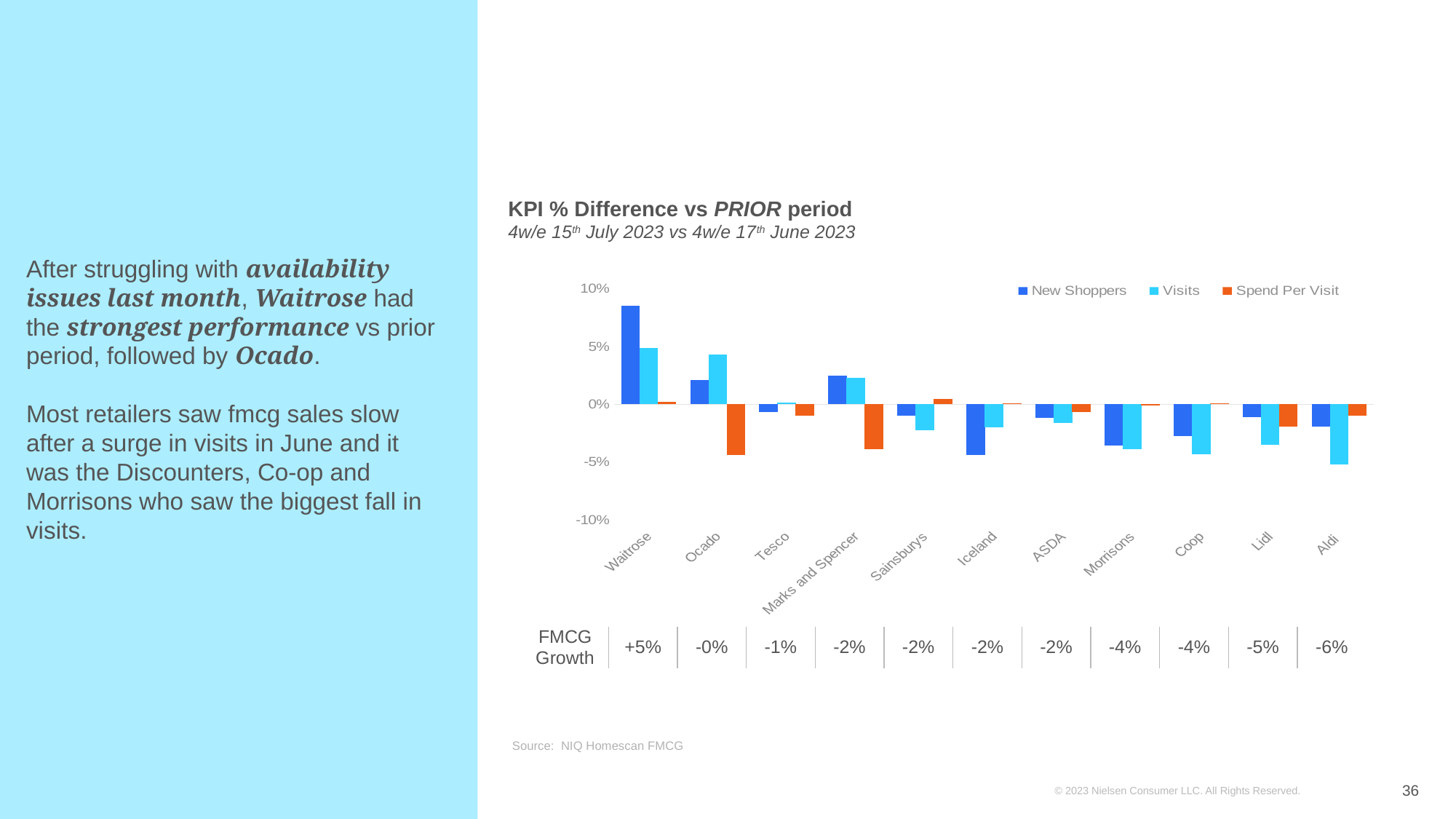
How many series does the legend list? 3 How many retailers are shown on the x axis of the chart? 11 Is the New Shoppers value for Waitrose greater or less than 5%? greater Which series in the legend is shown in orange? Spend Per Visit What kind of chart is shown on the slide? bar chart Which retailer has the highest New Shoppers value? Waitrose Is the Spend Per Visit value for Ocado greater or less than 0%? less What is the FMCG Growth figure shown for Waitrose below the chart? +5% Do the New Shoppers values generally rise or fall moving from Waitrose to Aldi along the x axis? fall Which retailer has the lowest Visits value? Aldi Which is larger, the New Shoppers value for Waitrose or for Ocado? Waitrose